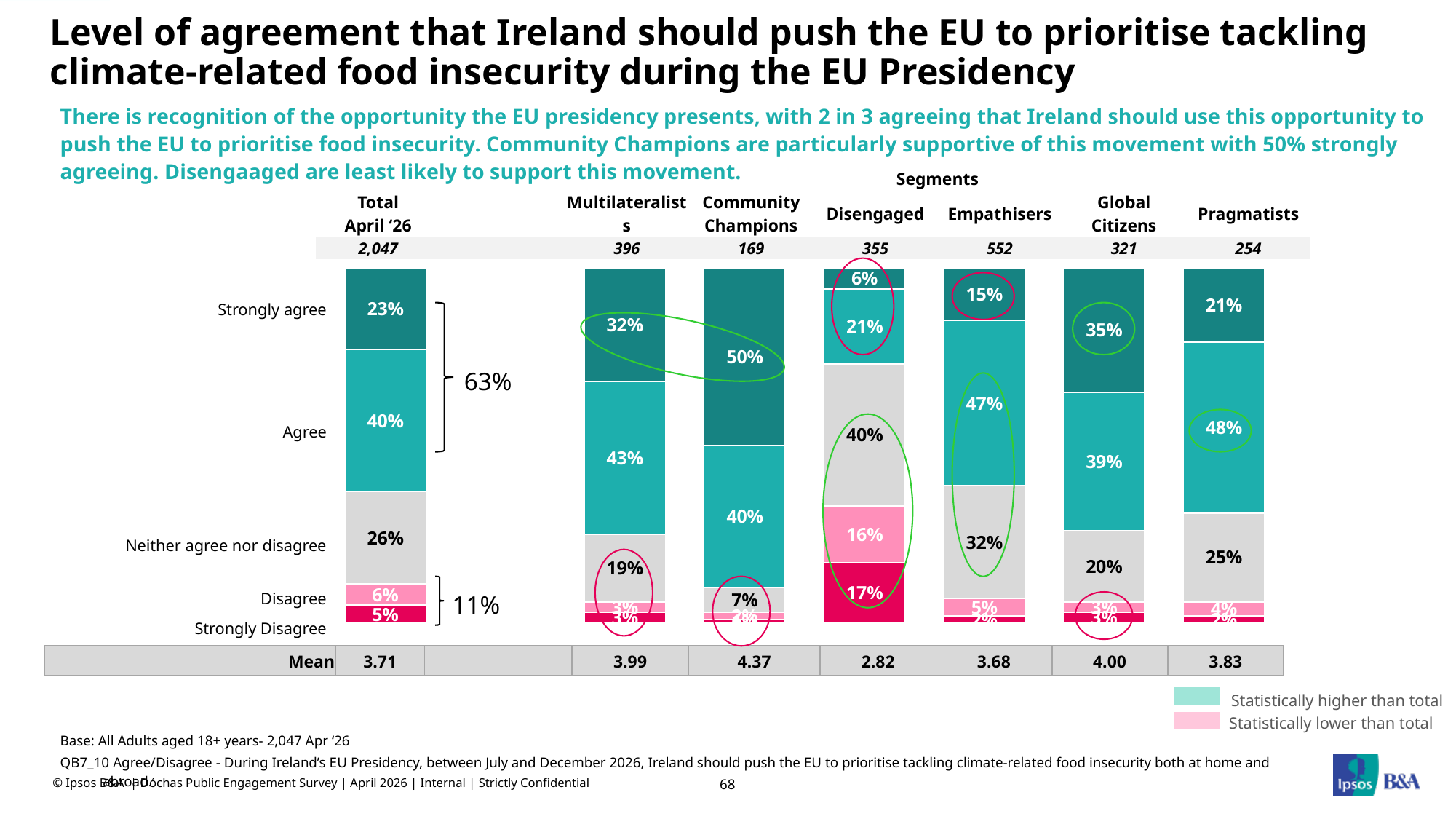
What is the base size shown for the Empathisers segment? 552 What is the combined percentage of Strongly agree and Agree for the Total April '26 bar? 63% What kind of chart is shown on the slide? Stacked bar chart What is the difference between the Agree percentage for Pragmatists and for Global Citizens? 9% Which segment has the lowest percentage strongly agreeing? Disengaged Which has a higher mean score, Multilateralists or Empathisers? Multilateralists What percentage of Community Champions strongly agree? 50% What percentage of the Total April '26 sample strongly agree? 23% Which segment has the highest percentage strongly agreeing? Community Champions How many bars (groups) are shown in the chart, including the Total? 7 What percentage of the Disengaged segment neither agree nor disagree? 40% What is the mean score for the Disengaged segment? 2.82